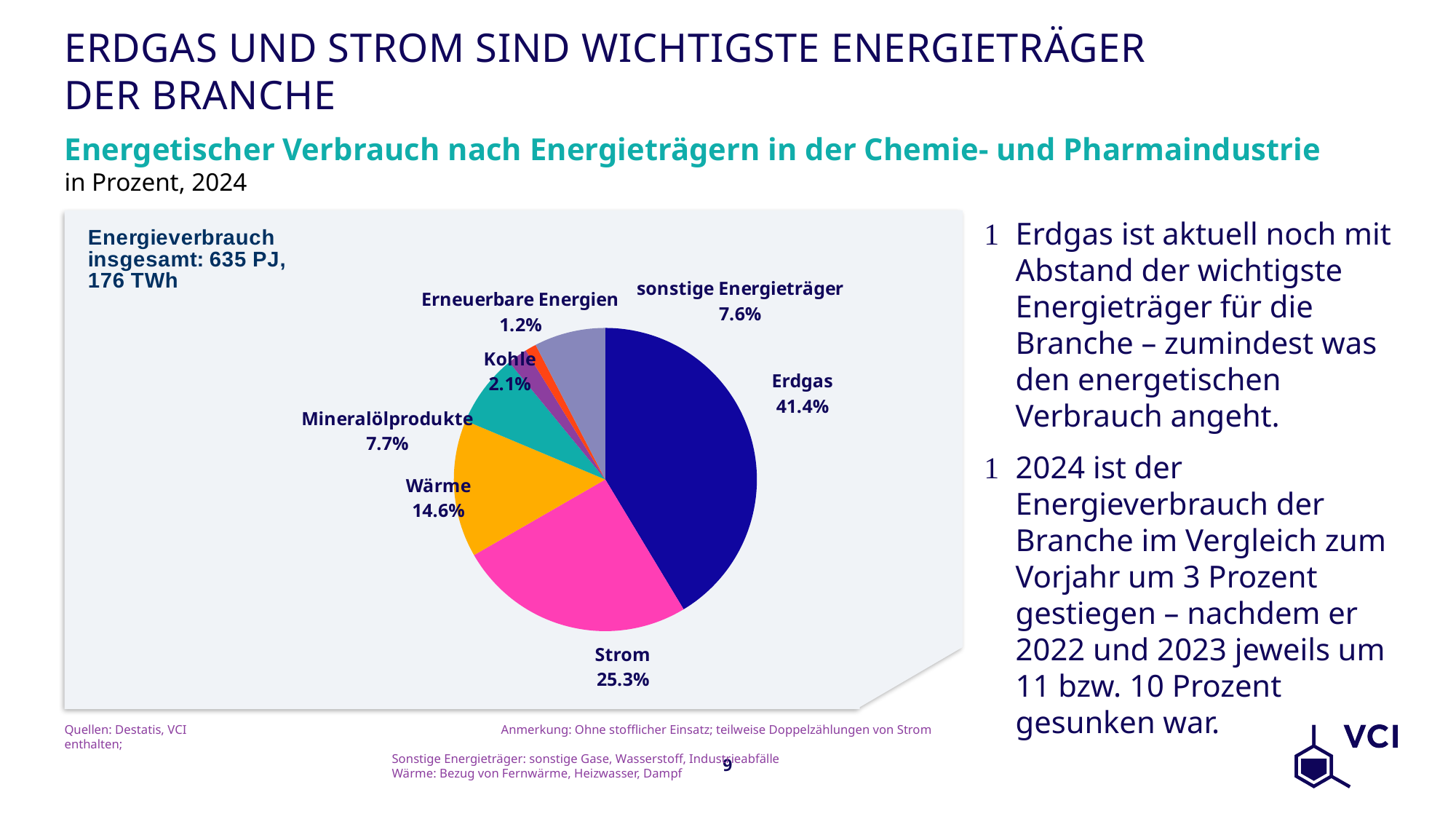
What share of energy consumption does Erdgas account for? 41.4% What share is shown for Kohle? 2.1% Which energy source has the smallest slice of the pie? Erneuerbare Energien What percentage is shown for Wärme? 14.6% What is the value for Mineralölprodukte? 7.7% What is the value shown for Strom? 25.3% What is the difference in percentage points between Erdgas and Strom? 16.1 What total energy consumption is stated in the chart box? 635 PJ, 176 TWh What type of chart is shown on the slide? Pie chart How many energy sources are shown in the pie chart? 7 Which energy source has the largest slice of the pie? Erdgas Which is larger, the share for Mineralölprodukte or the share for sonstige Energieträger? Mineralölprodukte